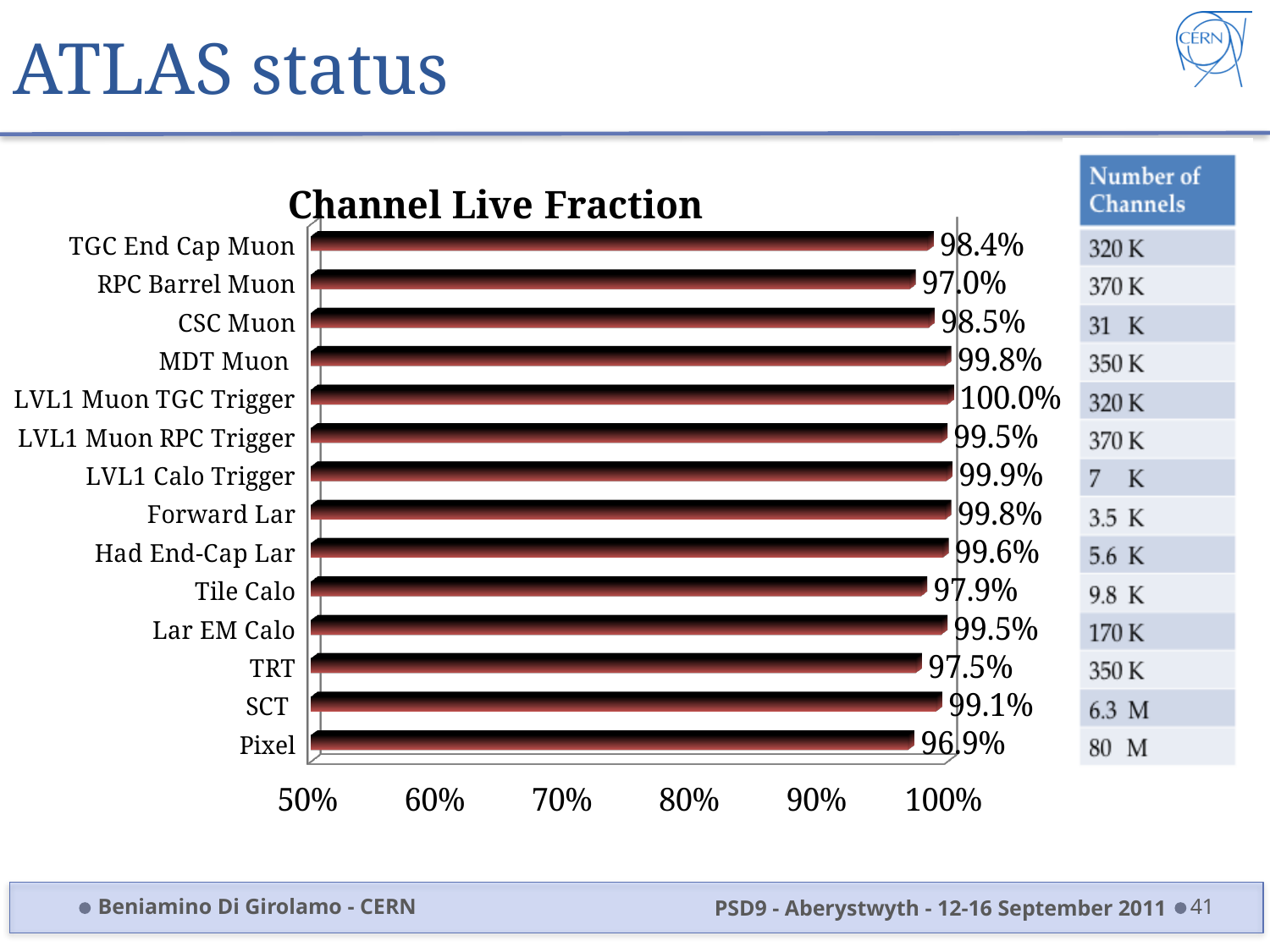
Which category has the lowest channel live fraction? Pixel What is the title of the chart? Channel Live Fraction Is the channel live fraction for RPC Barrel Muon greater or less than 90%? greater What is the channel live fraction for TRT? 97.5% What is the channel live fraction for Pixel? 96.9% What is the channel live fraction for MDT Muon? 99.8% What is the difference between the channel live fraction of LVL1 Muon TGC Trigger and Pixel? 3.1 percentage points Which has a higher channel live fraction, TRT or SCT? SCT How many categories are shown in the Channel Live Fraction chart? 14 Which category has the highest channel live fraction? LVL1 Muon TGC Trigger What kind of chart is the Channel Live Fraction chart? bar chart What is the lowest value shown on the x axis of the chart? 50%